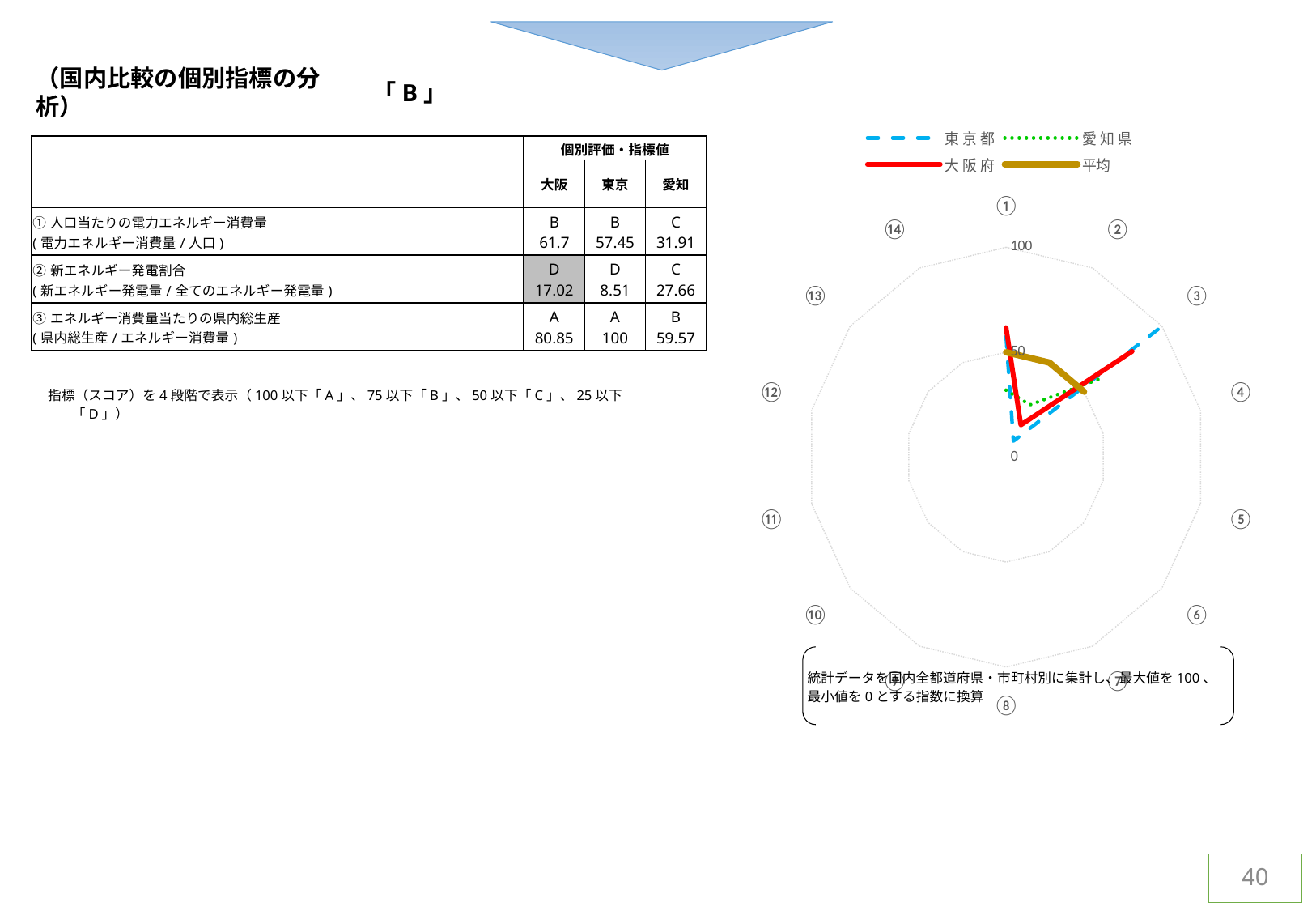
Which series in the radar chart is drawn as a red solid line? 大阪府 Which series reaches the highest value on axis ③ of the radar chart? 東京都 How many numbered axes does the radar chart have? 14 On the radar chart, is the value for 東京都 on axis ③ greater or less than 50? greater What is the highest value printed on the radar chart's scale? 100 On axis ③ of the radar chart, which is larger, the value for 大阪府 or for 愛知県? 大阪府 Which series has the lowest value on axis ② of the radar chart? 東京都 On the radar chart, is the value for 愛知県 on axis ① greater or less than 50? less How many series does the legend of the radar chart list? 4 On the radar chart, is the value for 大阪府 on axis ② greater or less than 50? less What is the difference between the 大阪 and 東京 values for indicator ① (人口当たりの電力エネルギー消費量)? 4.25 What kind of chart is shown on the right side of the slide? radar chart